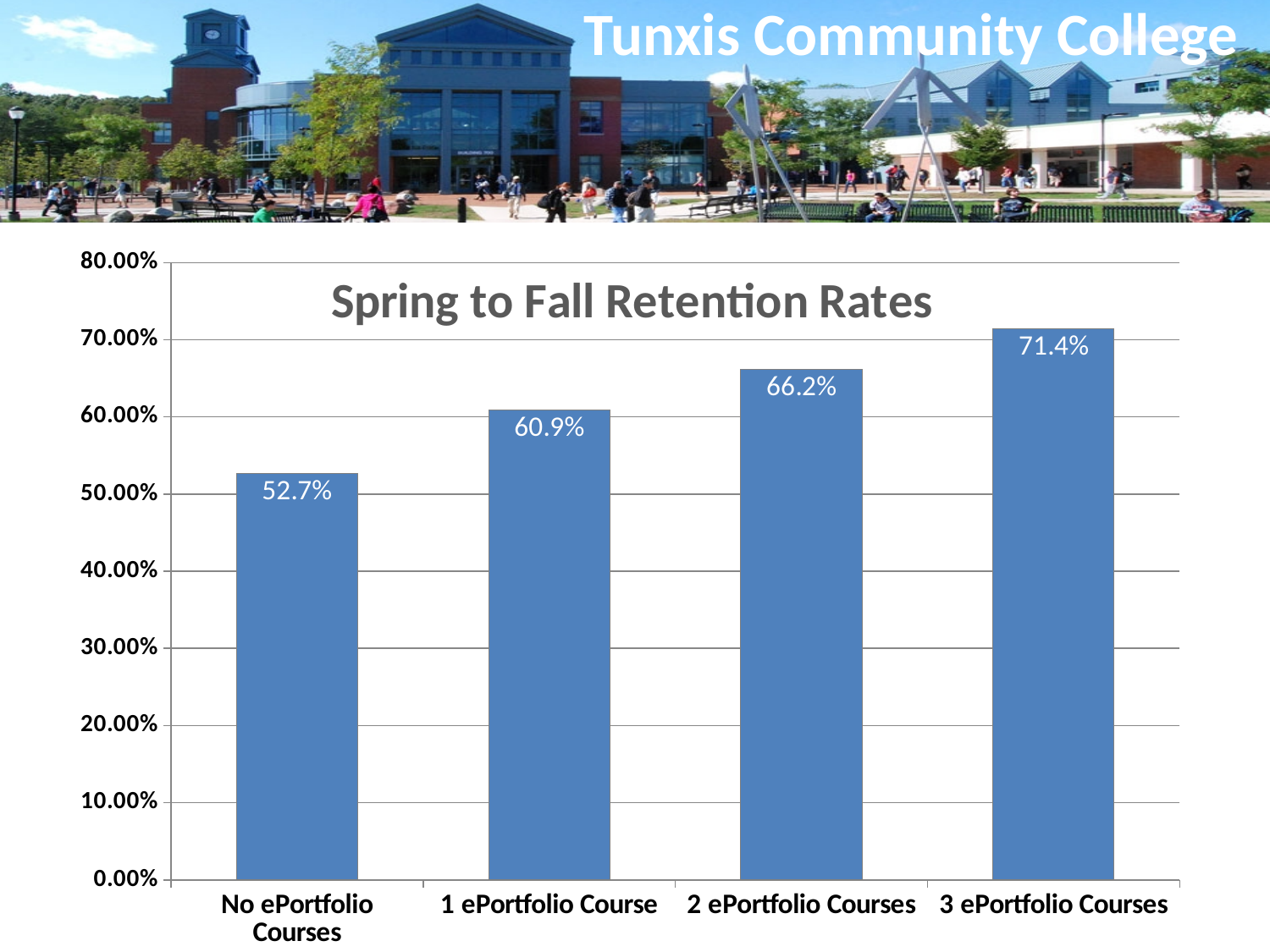
Which has a higher retention rate, 1 ePortfolio Course or 2 ePortfolio Courses? 2 ePortfolio Courses Which category has the highest Spring to Fall retention rate? 3 ePortfolio Courses What is the Spring to Fall retention rate for students with No ePortfolio Courses? 52.7% Do the retention rates rise or fall as the number of ePortfolio courses increases along the x axis? Rise What is the retention rate for students with 2 ePortfolio Courses? 66.2% What is the retention rate for students with 1 ePortfolio Course? 60.9% Which category has the lowest Spring to Fall retention rate? No ePortfolio Courses How many categories are shown in the chart? 4 What is the difference in retention rate between 2 ePortfolio Courses and 1 ePortfolio Course? 5.3% What is the difference in retention rate between 3 ePortfolio Courses and No ePortfolio Courses? 18.7% What is the retention rate for students with 3 ePortfolio Courses? 71.4% What kind of chart is shown on the slide? Bar chart